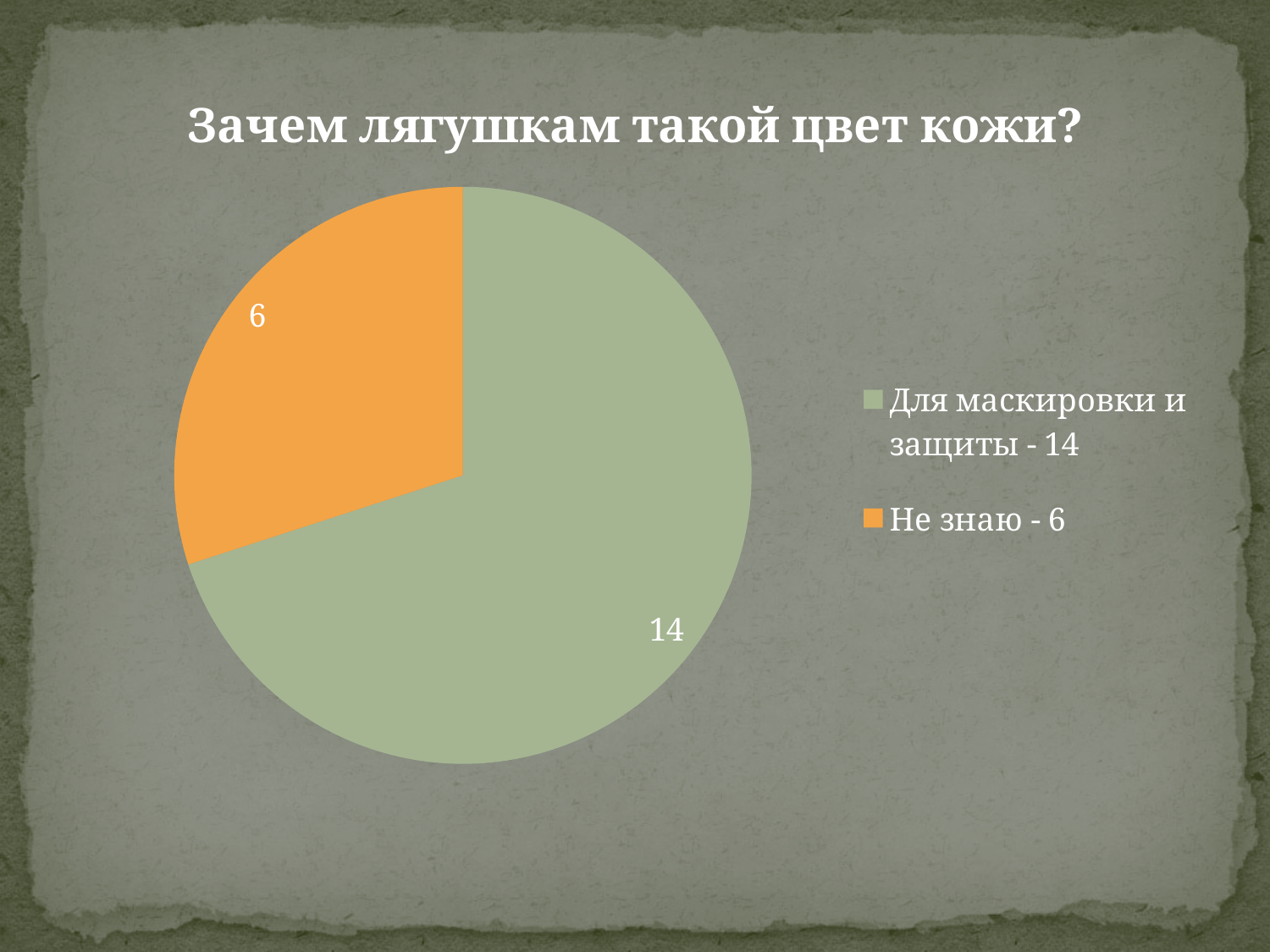
What share of the pie does "Не знаю" represent? 30% How many entries does the legend list? 2 Which category has the largest slice? Для маскировки и защиты Which is larger: "Для маскировки и защиты" or "Не знаю"? Для маскировки и защиты What type of chart is shown on the slide? pie chart Which category has the smallest slice? Не знаю What is the title of the chart? Зачем лягушкам такой цвет кожи? What is the difference between the values for "Для маскировки и защиты" and "Не знаю"? 8 What is the value for "Не знаю"? 6 What is the total of all slices in the pie chart? 20 What is the value for "Для маскировки и защиты"? 14 How many slices does the pie chart have? 2